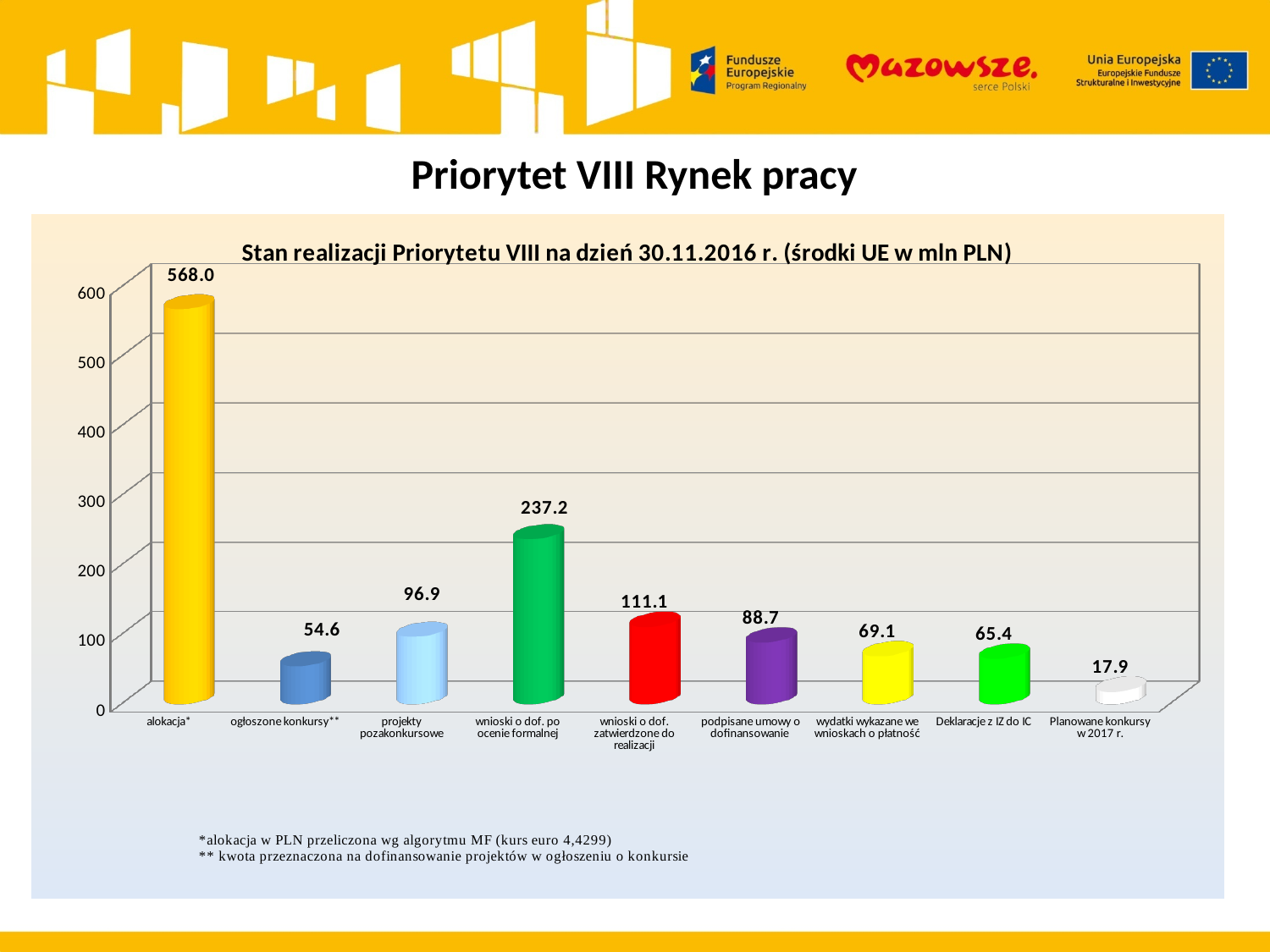
How many categories are shown on the x axis? 9 What is the difference between the values for 'alokacja*' and 'wnioski o dof. po ocenie formalnej'? 330.8 What is the difference between the values for 'wnioski o dof. zatwierdzone do realizacji' and 'podpisane umowy o dofinansowanie'? 22.4 What kind of chart is shown on the slide? bar chart Which category has the highest value? alokacja* What is the value for 'wnioski o dof. po ocenie formalnej'? 237.2 What is the value for 'alokacja*'? 568.0 What is the title of the chart? Stan realizacji Priorytetu VIII na dzień 30.11.2016 r. (środki UE w mln PLN) What is the value for 'podpisane umowy o dofinansowanie'? 88.7 What is the value for 'Planowane konkursy w 2017 r.'? 17.9 Which is larger, the value for 'projekty pozakonkursowe' or the value for 'ogłoszone konkursy**'? projekty pozakonkursowe Which category has the lowest value? Planowane konkursy w 2017 r.